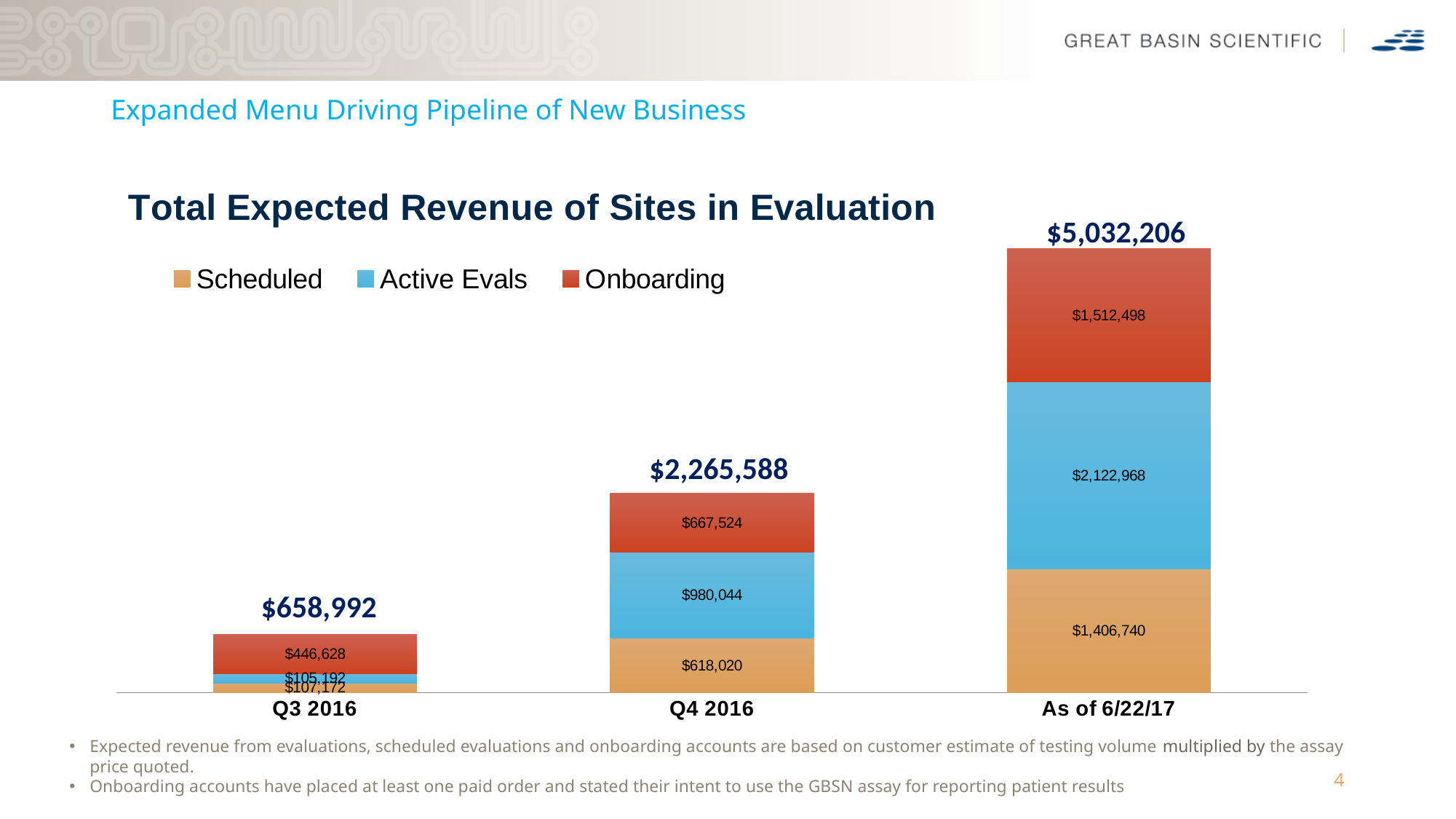
Which period has the lowest total expected revenue? Q3 2016 What is the Active Evals value for Q4 2016? $980,044 What is the Onboarding value for Q3 2016? $446,628 Which period has the highest total expected revenue? As of 6/22/17 What is the Scheduled value for Q4 2016? $618,020 What is the total expected revenue shown above the bar for As of 6/22/17? $5,032,206 How many series does the legend list? 3 What is the difference between the Active Evals value for As of 6/22/17 and the Active Evals value for Q4 2016? $1,142,924 What kind of chart is shown on the slide? Stacked bar chart Which is larger for Q4 2016, the Active Evals value or the Onboarding value? Active Evals What is the Onboarding value for As of 6/22/17? $1,512,498 What is the total expected revenue shown above the bar for Q4 2016? $2,265,588